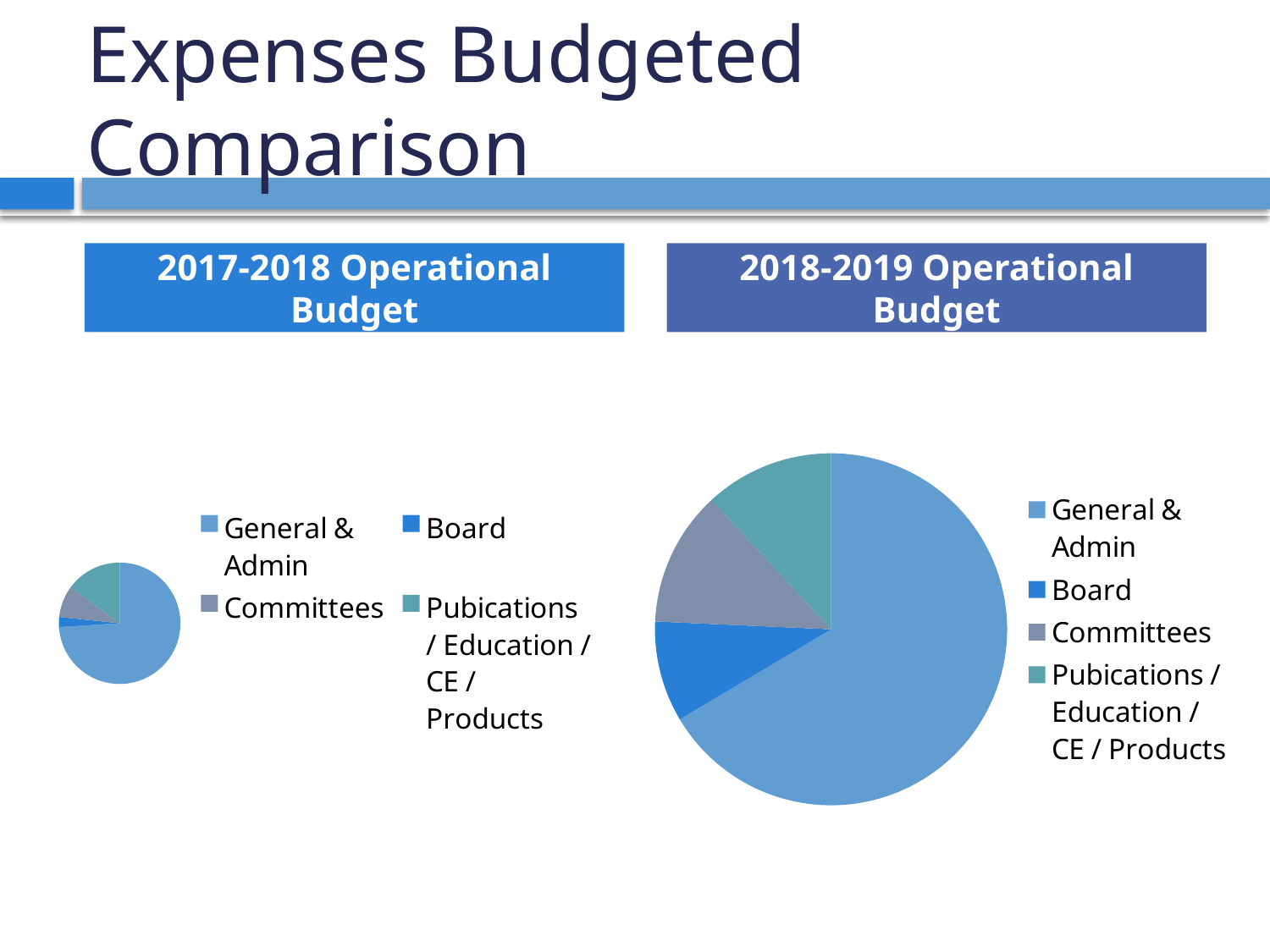
In the 2018-2019 Operational Budget chart, which is larger, General & Admin or Board? General & Admin What is the title of the chart on the right side of the slide? 2018-2019 Operational Budget In the 2017-2018 Operational Budget chart, which category has the largest slice? General & Admin In the 2018-2019 Operational Budget chart, which legend entry is shown in teal/green? Pubications / Education / CE / Products What kind of chart is used for the 2018-2019 Operational Budget? Pie chart In the 2018-2019 Operational Budget chart, which category has the largest slice? General & Admin What kind of chart is used for the 2017-2018 Operational Budget? Pie chart In the 2017-2018 Operational Budget chart, how many categories does the legend list? 4 In the 2017-2018 Operational Budget chart, which category has the smallest slice? Board In the 2017-2018 Operational Budget chart, which is larger, Committees or General & Admin? General & Admin In the 2018-2019 Operational Budget chart, how many slices does the pie have? 4